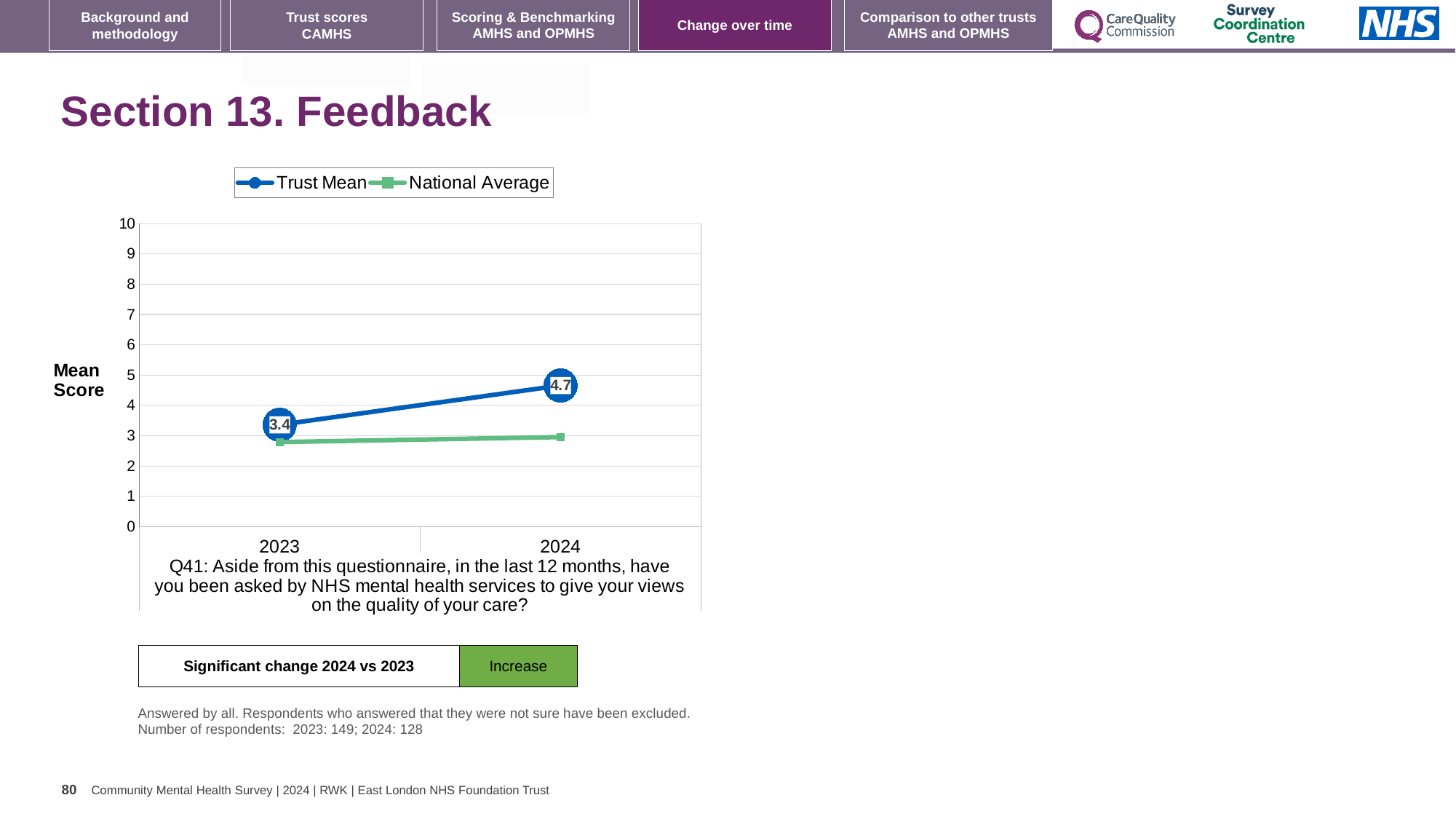
Is the Trust Mean for 2024 greater or less than 4? greater How many years are shown on the x axis? 2 Which year has the higher Trust Mean score? 2024 By how much did the Trust Mean change from 2023 to 2024? 1.3 In 2024, which is larger: the Trust Mean or the National Average? Trust Mean What is the Trust Mean score for 2023? 3.4 What is the Trust Mean score for 2024? 4.7 How many series does the legend list? 2 What type of chart is shown on the slide? line chart Does the Trust Mean rise or fall from 2023 to 2024? rise Is the National Average for 2023 greater or less than 3? less Which year has the lower Trust Mean score? 2023